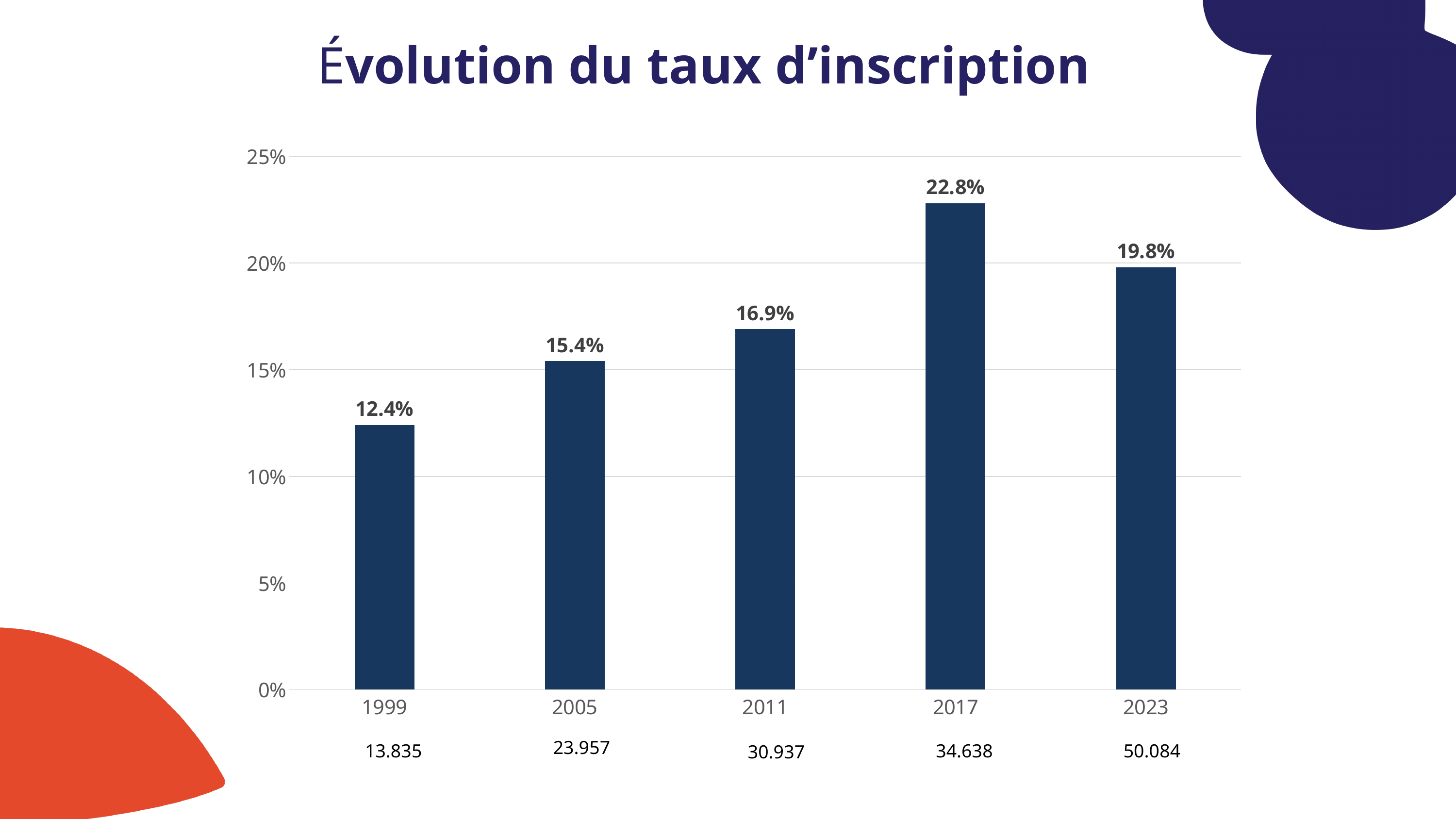
What is the value for 2017? 22.8% What kind of chart is shown on the slide? bar chart Which year has the highest value? 2017 Is the value for 2023 greater or less than 20%? less What is the value for 2023? 19.8% What is the value for 1999? 12.4% How many years are shown on the chart? 5 Which year has the lowest value? 1999 What is the difference between the values for 2017 and 2023? 3.0% Which is larger, the value for 2005 or the value for 2011? 2011 What is the title of the chart? Évolution du taux d’inscription What is the difference between the values for 2011 and 2005? 1.5%